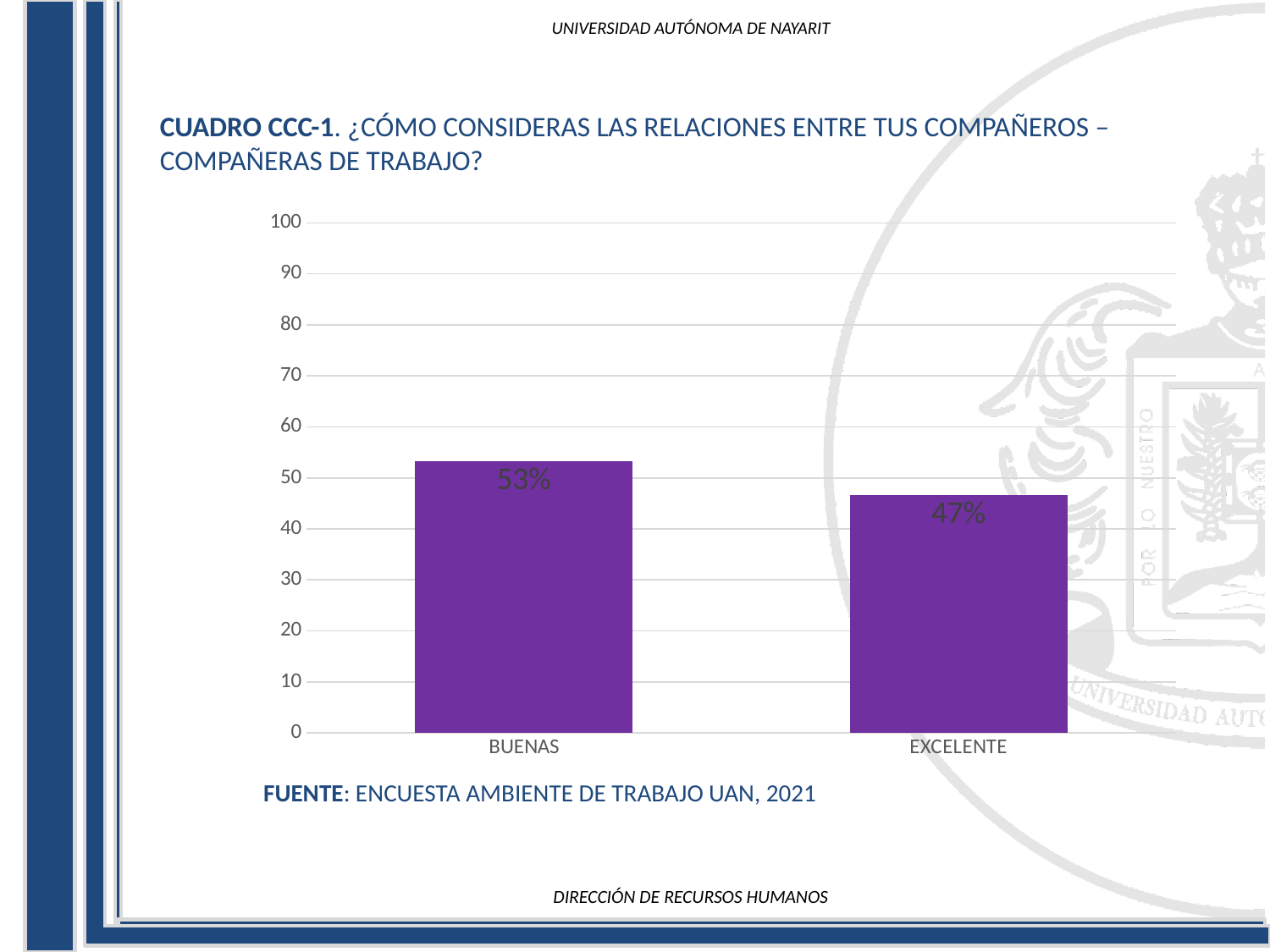
What is the maximum value shown on the y axis? 100 Is the value for EXCELENTE greater or less than 50? less Which is larger, the value for BUENAS or the value for EXCELENTE? BUENAS What is the value for EXCELENTE? 47% What is the source cited below the chart? ENCUESTA AMBIENTE DE TRABAJO UAN, 2021 What kind of chart is shown on the slide? bar chart What is the difference between the values for BUENAS and EXCELENTE? 6% How many categories are shown on the x axis? 2 What is the value for BUENAS? 53% Which category has the lowest value? EXCELENTE Is the value for BUENAS greater or less than 50? greater Which category has the highest value? BUENAS